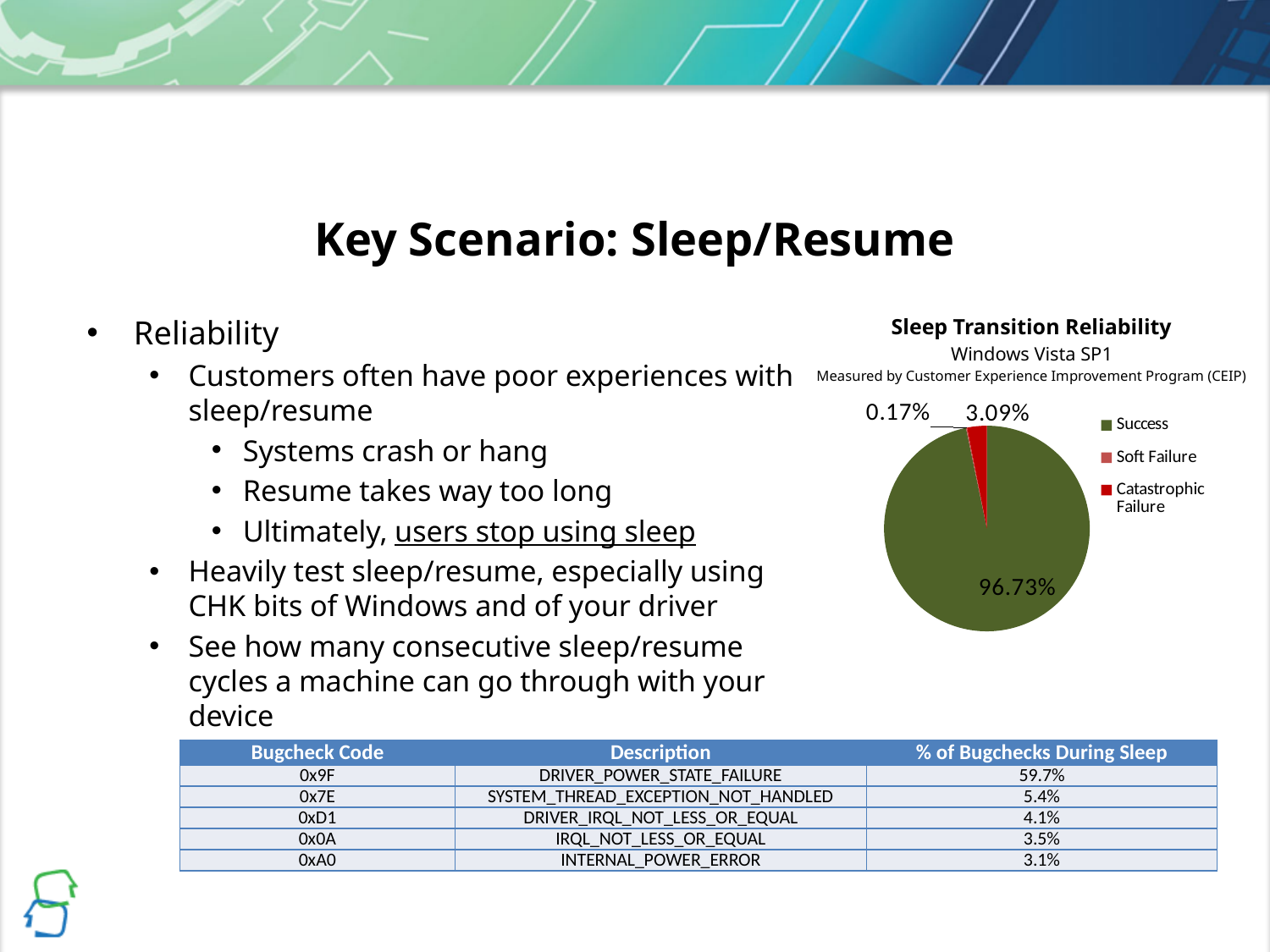
What type of chart is the Sleep Transition Reliability chart? pie chart In the Sleep Transition Reliability pie chart, what is the difference between the Soft Failure and Catastrophic Failure percentages? 2.92% In the Sleep Transition Reliability pie chart, what percentage is shown for Success? 96.73% Which category has the smallest slice in the Sleep Transition Reliability pie chart? Soft Failure In the Sleep Transition Reliability pie chart, which is larger: Soft Failure or Catastrophic Failure? Catastrophic Failure In the Sleep Transition Reliability pie chart, what percentage is shown for Catastrophic Failure? 3.09% Which category has the largest slice in the Sleep Transition Reliability pie chart? Success In the Sleep Transition Reliability pie chart, what is the combined share of Soft Failure and Catastrophic Failure? 3.26% How many categories does the legend of the Sleep Transition Reliability pie chart list? 3 What colour is the Success slice in the Sleep Transition Reliability pie chart? green Which Windows version does the Sleep Transition Reliability chart cover, according to its subtitle? Windows Vista SP1 In the Sleep Transition Reliability pie chart, what percentage is shown for Soft Failure? 0.17%